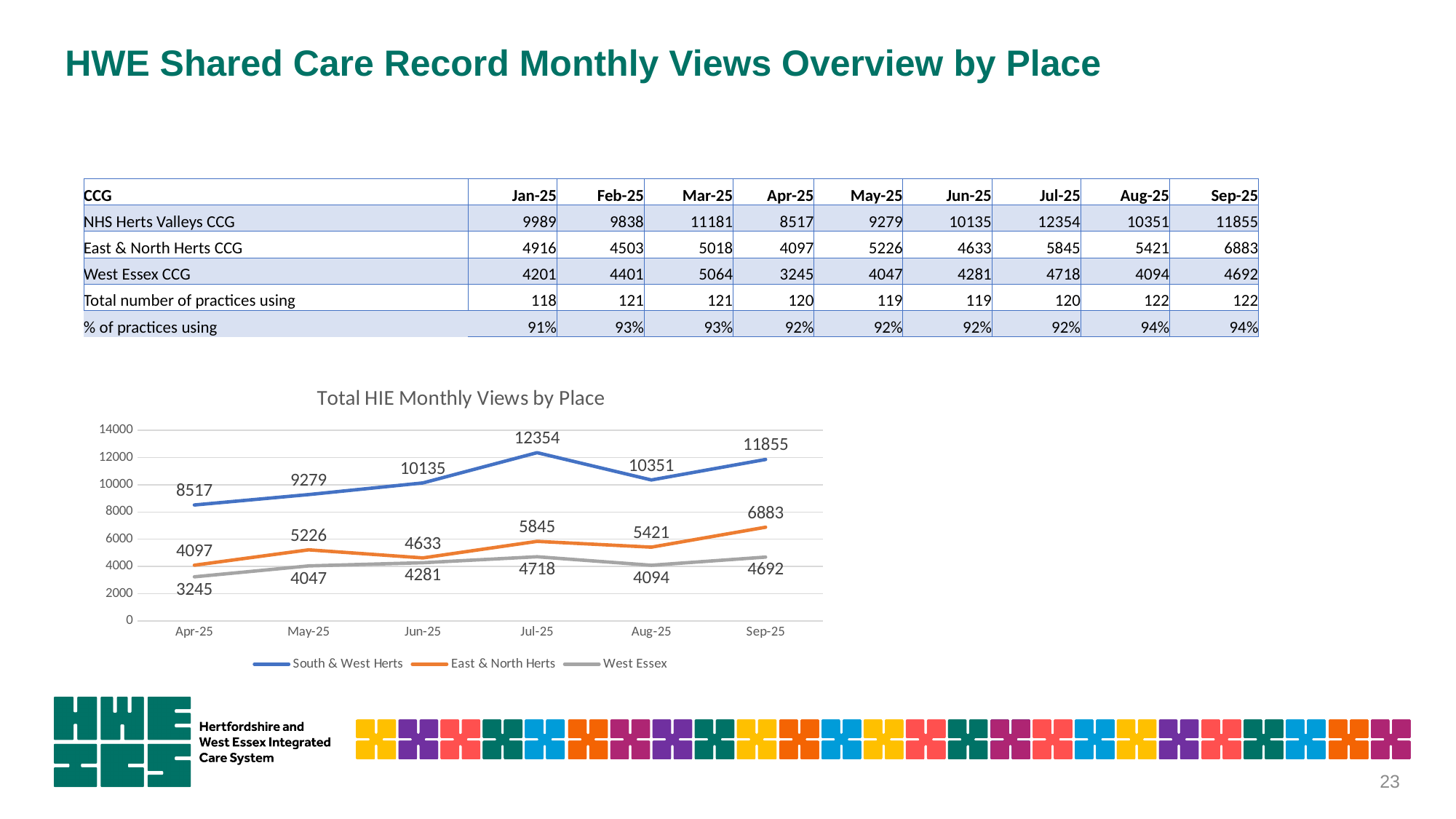
What is the title of the chart? Total HIE Monthly Views by Place What is the value for South & West Herts in Jul-25? 12354 What is the value for East & North Herts in Sep-25? 6883 How many series does the chart legend list? 3 Is the value for South & West Herts in Apr-25 greater or less than 10000? less In which month does South & West Herts reach its highest value? Jul-25 In which month is the West Essex value lowest? Apr-25 What kind of chart is shown on the slide? line chart Which is larger in Aug-25: East & North Herts or West Essex? East & North Herts What is the difference between the South & West Herts and East & North Herts values in Sep-25? 4972 What is the value for West Essex in Apr-25? 3245 How many months are shown on the x axis of the chart? 6